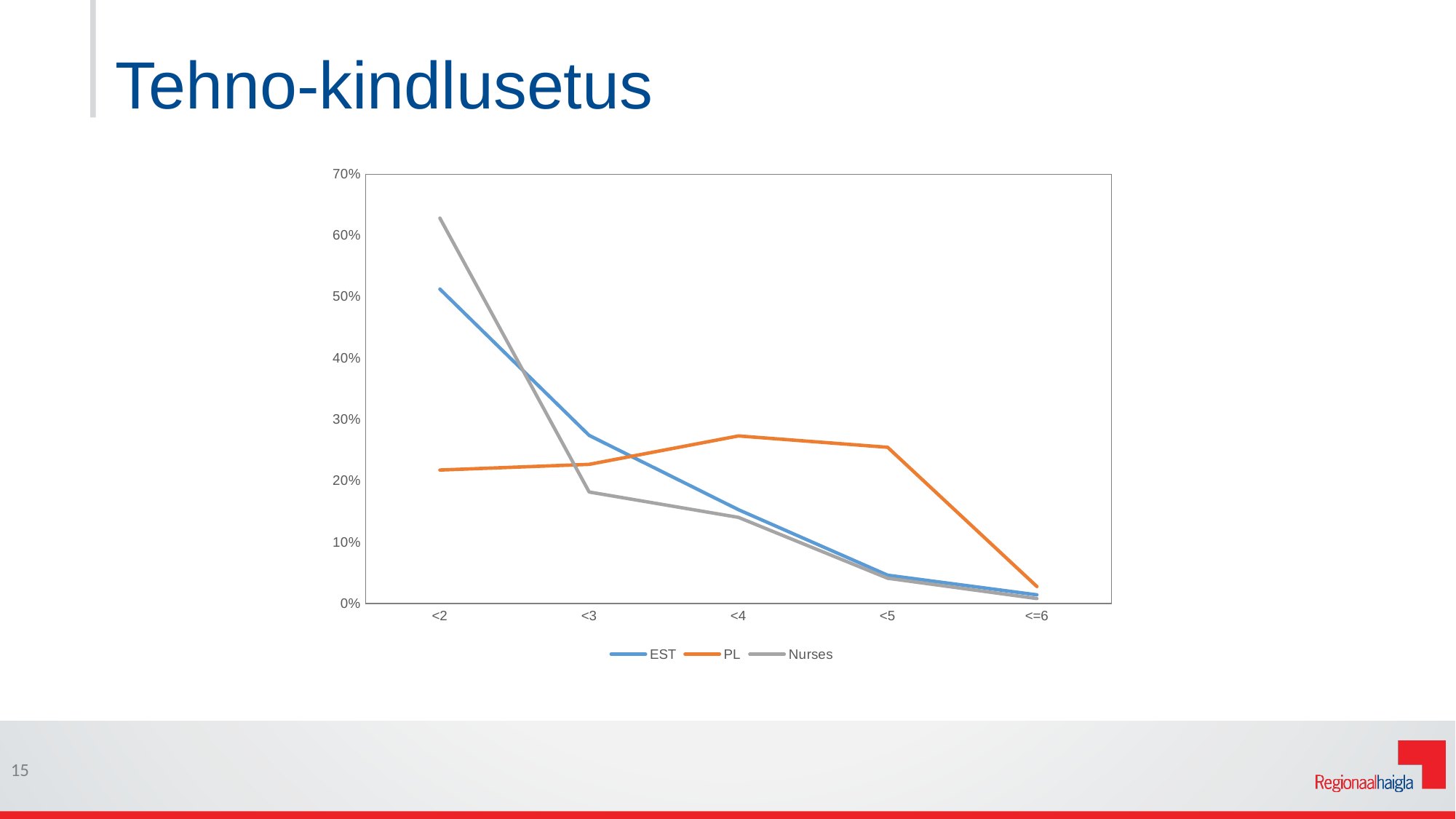
How many categories are shown on the x axis? 5 Is the value for PL at <=6 greater or less than 10%? less Is the value for Nurses at <3 greater or less than 20%? less Which category has the highest value for the Nurses series? <2 Is the value for EST at <2 greater or less than 50%? greater Does the EST series rise or fall from <2 to <=6? fall At <5, which series has the larger value, PL or EST? PL How many series does the legend list? 3 Which category has the highest value for the PL series? <4 At <2, which series has the larger value, EST or Nurses? Nurses What kind of chart is shown on the slide? line chart